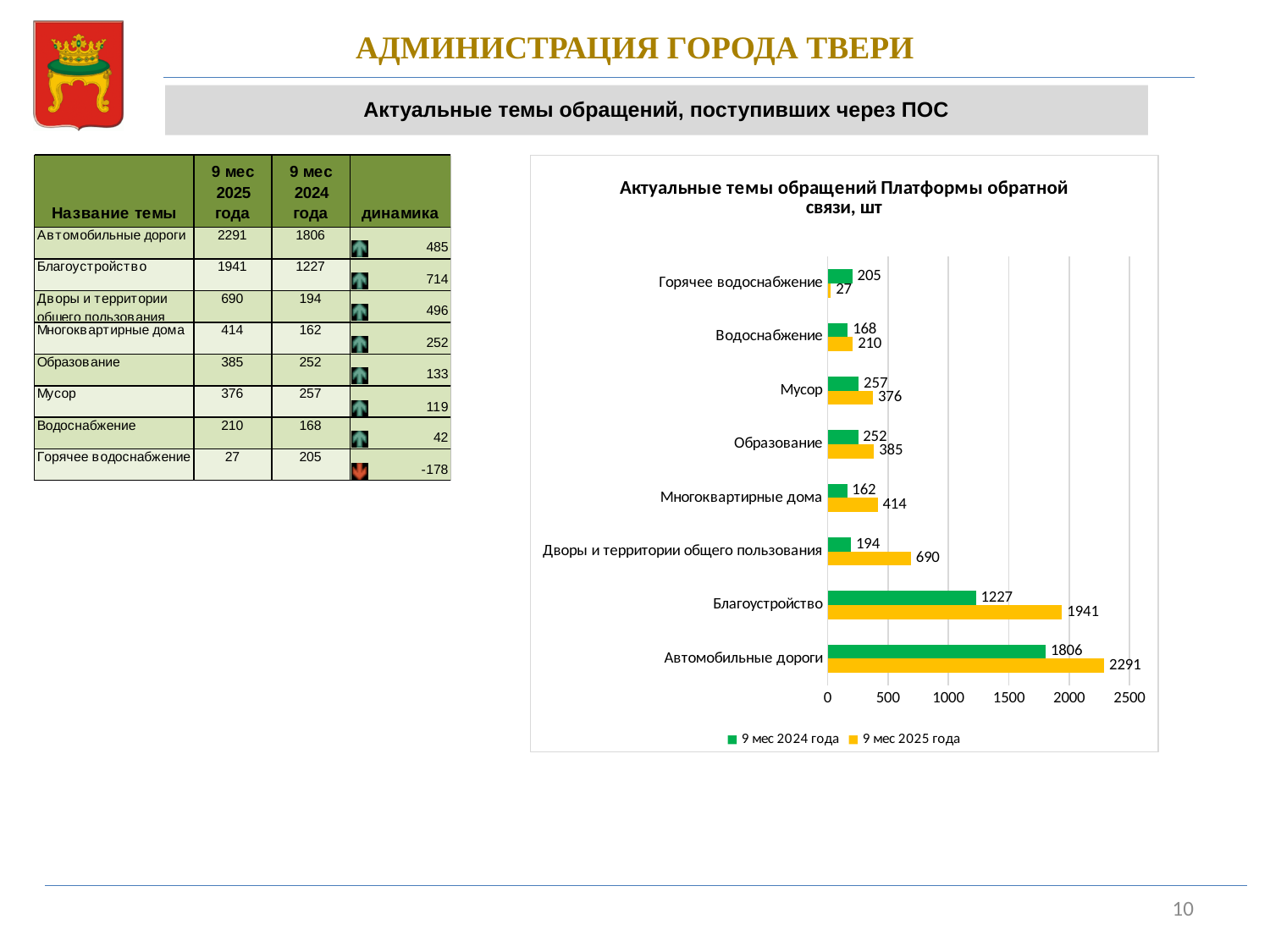
Which category has the highest value in the 9 мес 2025 года series? Автомобильные дороги For Водоснабжение, which series has the larger value: 9 мес 2024 года or 9 мес 2025 года? 9 мес 2025 года What is the value for Горячее водоснабжение in the 9 мес 2025 года series? 27 What is the title of the chart? Актуальные темы обращений Платформы обратной связи, шт What is the difference between the 9 мес 2025 года and 9 мес 2024 года values for Дворы и территории общего пользования? 496 How many series does the legend list? 2 What kind of chart is shown on the slide? bar chart Is the 9 мес 2025 года value for Благоустройство greater or less than 1500? greater How many categories are shown on the chart? 8 What is the value for Автомобильные дороги in the 9 мес 2025 года series? 2291 What is the value for Благоустройство in the 9 мес 2024 года series? 1227 Which category has the lowest value in the 9 мес 2025 года series? Горячее водоснабжение